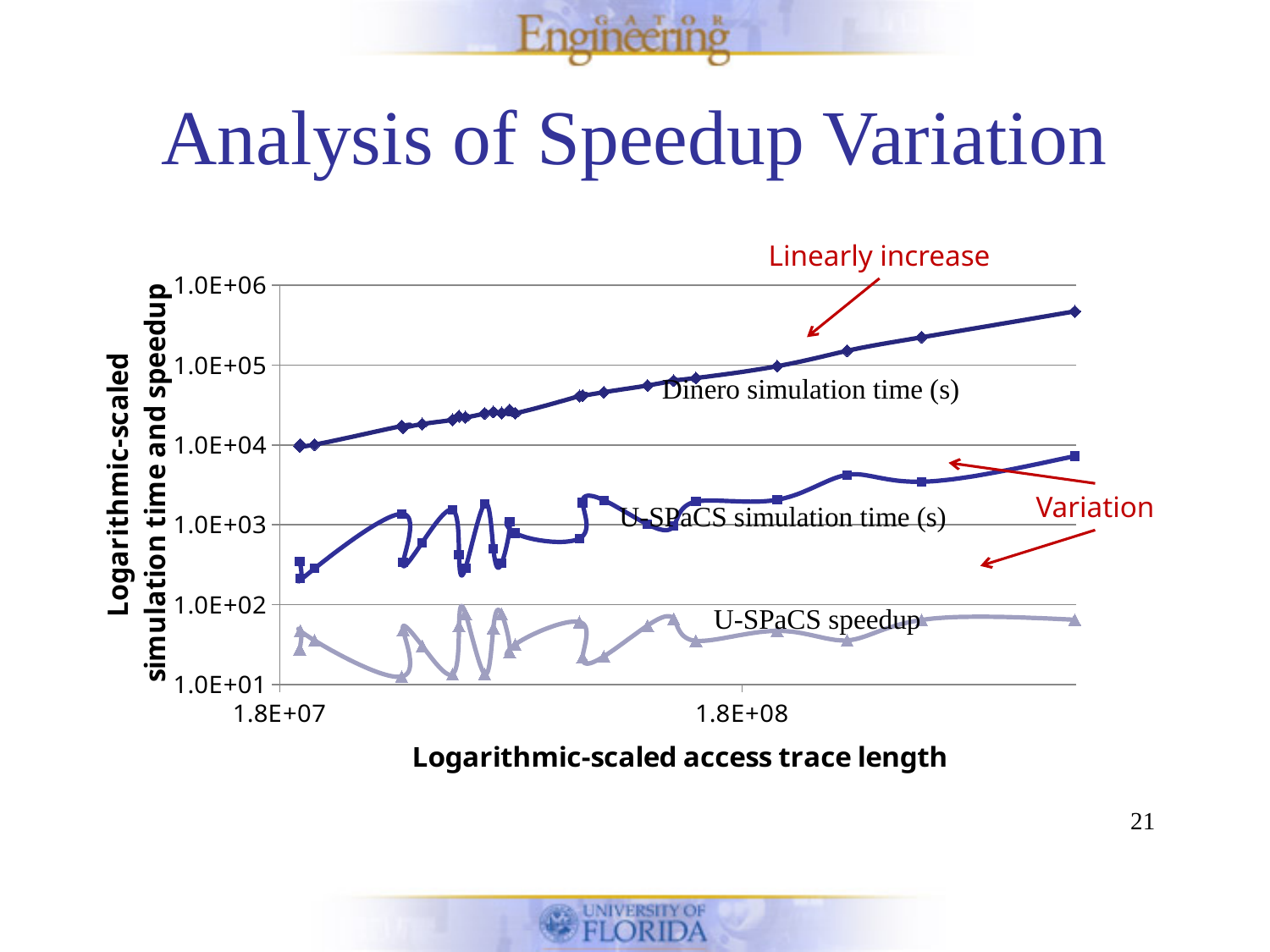
What kind of chart is shown on the slide? line chart Is the Dinero simulation time at the rightmost point greater or less than 1.0E+05? greater Does the Dinero simulation time rise or fall as the access trace length increases? rise What red annotation is attached to the Dinero simulation time line? Linearly increase Is the U-SPaCS simulation time at the rightmost point greater or less than 1.0E+04? less At the rightmost point, which is larger: the Dinero simulation time or the U-SPaCS simulation time? Dinero simulation time Which series has the lowest values across the chart? U-SPaCS speedup What is the title of the x axis? Logarithmic-scaled access trace length Which series has the highest values across the chart? Dinero simulation time (s) Is the U-SPaCS speedup at the rightmost point greater or less than 1.0E+02? less How many data series are plotted on the chart? 3